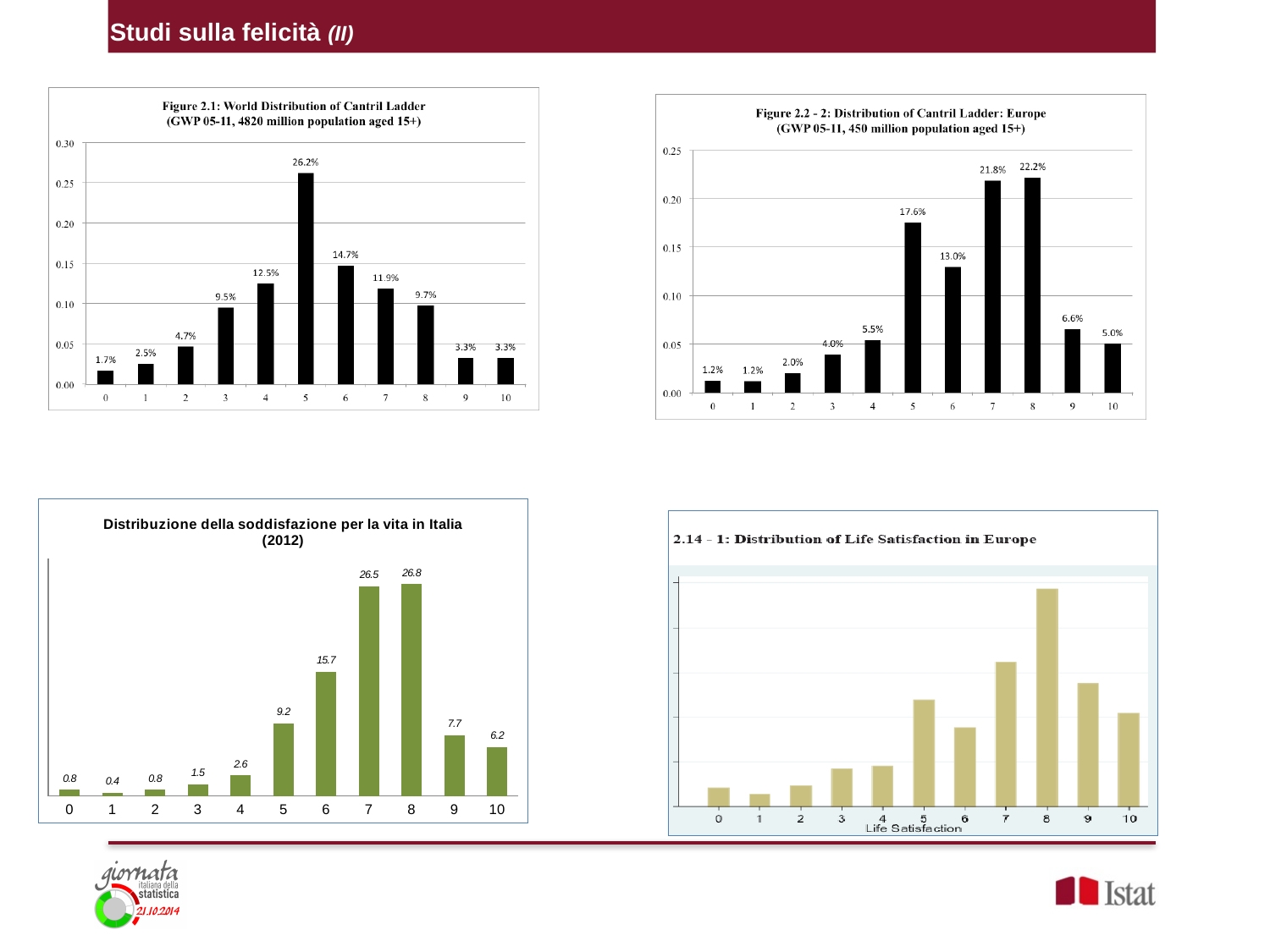
In the chart titled "Figure 2.2 - 2: Distribution of Cantril Ladder: Europe", what is the value for category 5? 17.6% In the chart titled "Distribuzione della soddisfazione per la vita in Italia (2012)", what is the difference between the values for categories 7 and 5? 17.3 How many categories are shown on the x axis of the chart titled "2.14 - 1: Distribution of Life Satisfaction in Europe"? 11 In the chart titled "Figure 2.1: World Distribution of Cantril Ladder", which category has the lowest value? 0 What kind of chart is the chart titled "2.14 - 1: Distribution of Life Satisfaction in Europe"? bar chart In the chart titled "Figure 2.2 - 2: Distribution of Cantril Ladder: Europe", is the value for category 9 larger or smaller than the value for category 10? larger In the chart titled "Figure 2.1: World Distribution of Cantril Ladder", what is the difference between the values for categories 6 and 7? 2.8% In the chart titled "2.14 - 1: Distribution of Life Satisfaction in Europe", which category has the highest bar? 8 In the chart titled "Distribuzione della soddisfazione per la vita in Italia (2012)", which category has the lowest value? 1 In the chart titled "Distribuzione della soddisfazione per la vita in Italia (2012)", what is the value for category 6? 15.7 In the chart titled "Figure 2.2 - 2: Distribution of Cantril Ladder: Europe", which category has the highest value? 8 In the chart titled "Figure 2.1: World Distribution of Cantril Ladder", what is the value for category 5? 26.2%